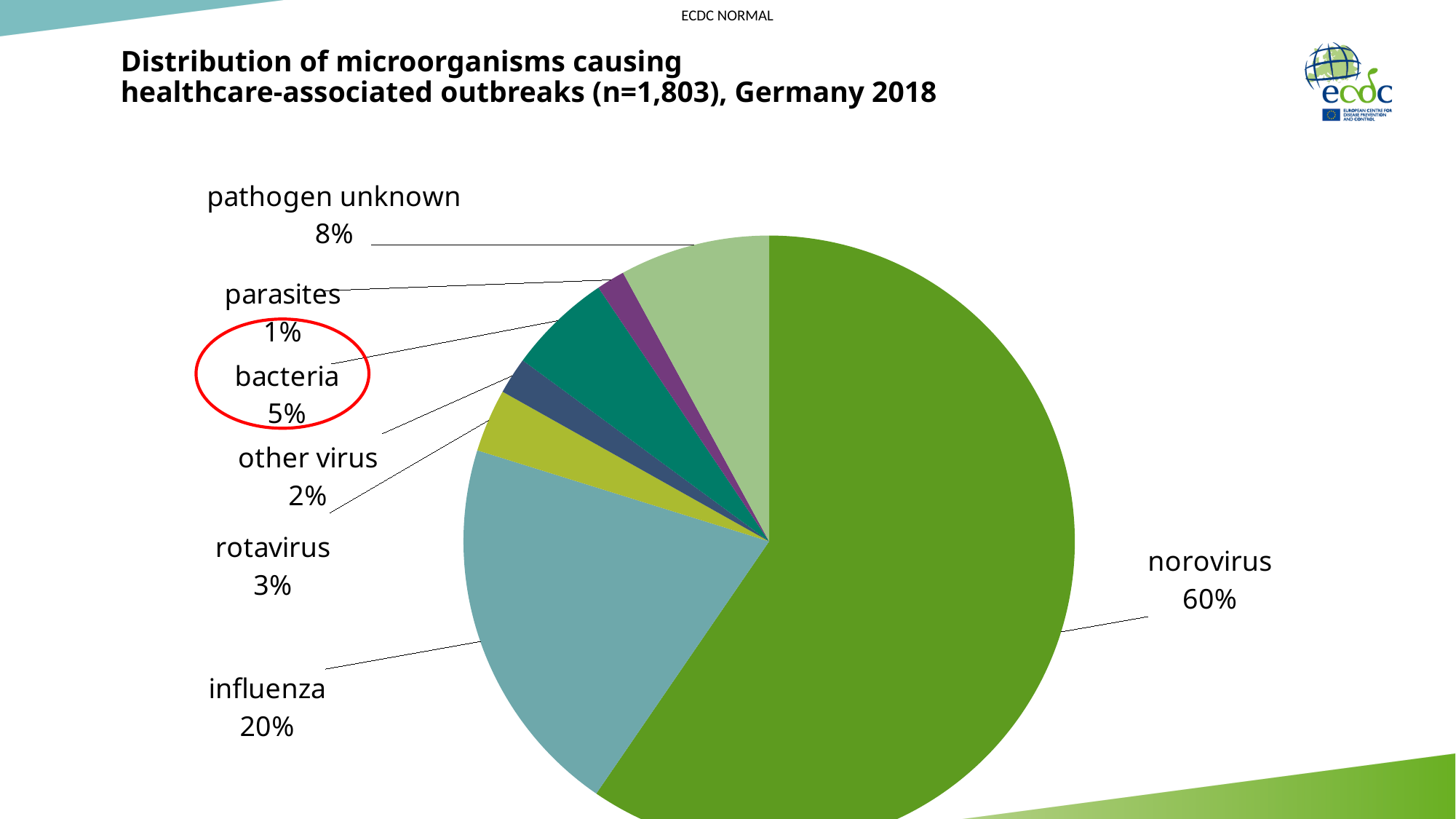
Which category accounts for the smallest share of outbreaks? parasites What share of healthcare-associated outbreaks is attributed to norovirus? 60% What is the total number of outbreaks (n) stated in the chart title? 1,803 Which microorganism accounts for the largest share of outbreaks? norovirus Which has a larger share of outbreaks, bacteria or other virus? bacteria What is the difference in percentage points between the norovirus and influenza shares? 40 What percentage of outbreaks is attributed to influenza? 20% What percentage of outbreaks is attributed to bacteria? 5% What kind of chart is shown on the slide? pie chart How many categories are shown in the pie chart? 7 What percentage of outbreaks has the pathogen unknown? 8% What percentage of outbreaks is attributed to rotavirus? 3%